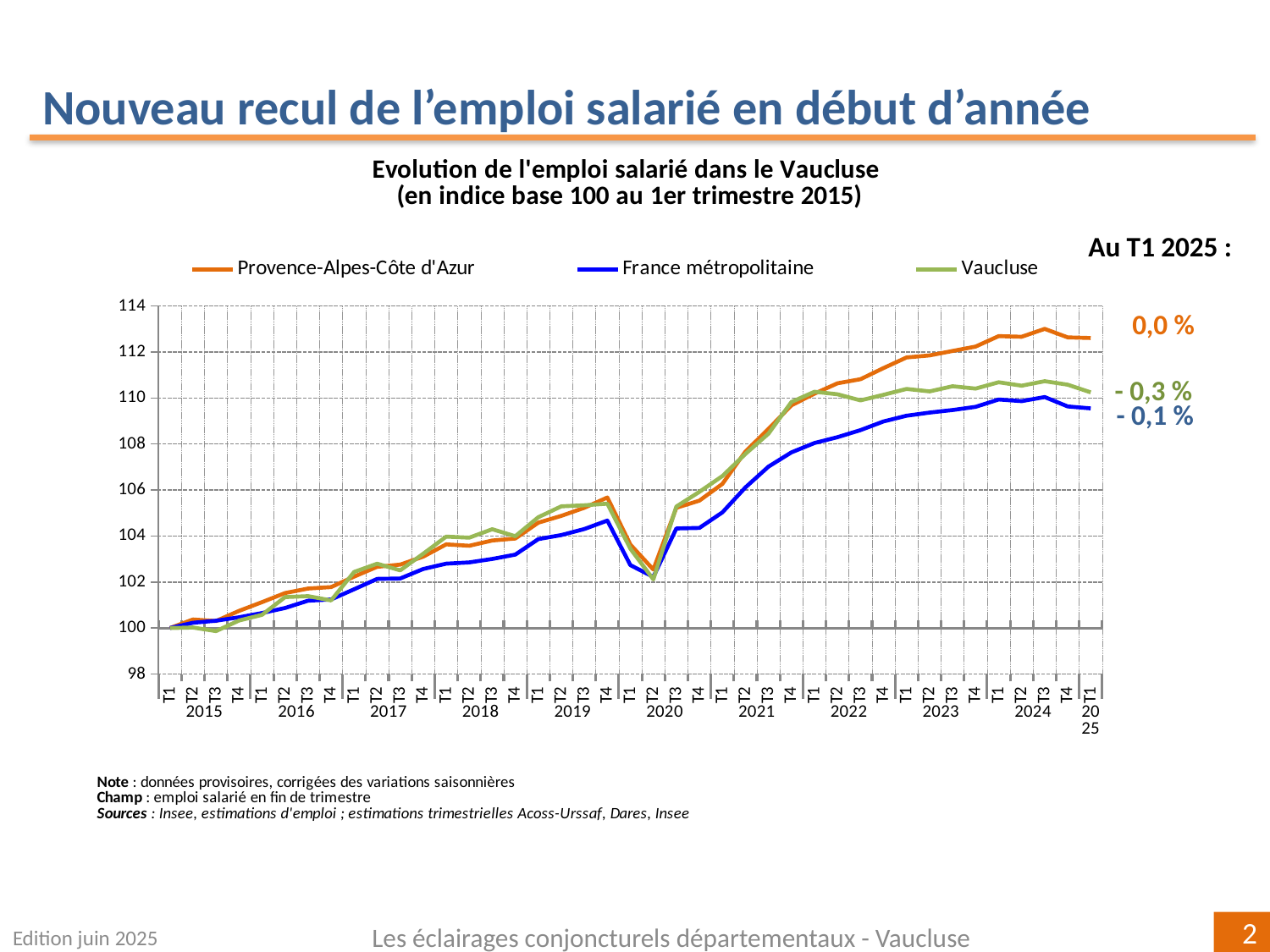
Is the value for France métropolitaine at T1 2025 greater or less than 110? less Which series has the highest index value at T1 2025? Provence-Alpes-Côte d'Azur Which series is drawn in orange? Provence-Alpes-Côte d'Azur Is the value for Provence-Alpes-Côte d'Azur at T1 2025 greater or less than 112? greater What is the quarterly change shown for Vaucluse at T1 2025? - 0,3 % Is the value for Vaucluse at T2 2020 greater or less than 104? less How many series does the legend list? 3 What is the quarterly change shown for France métropolitaine at T1 2025? - 0,1 % What is the quarterly change shown for Provence-Alpes-Côte d'Azur at T1 2025? 0,0 % Which series has the lowest index value at T1 2025? France métropolitaine Overall, do the index values rise or fall from T1 2015 to T1 2025? rise What kind of chart is shown on the slide? line chart